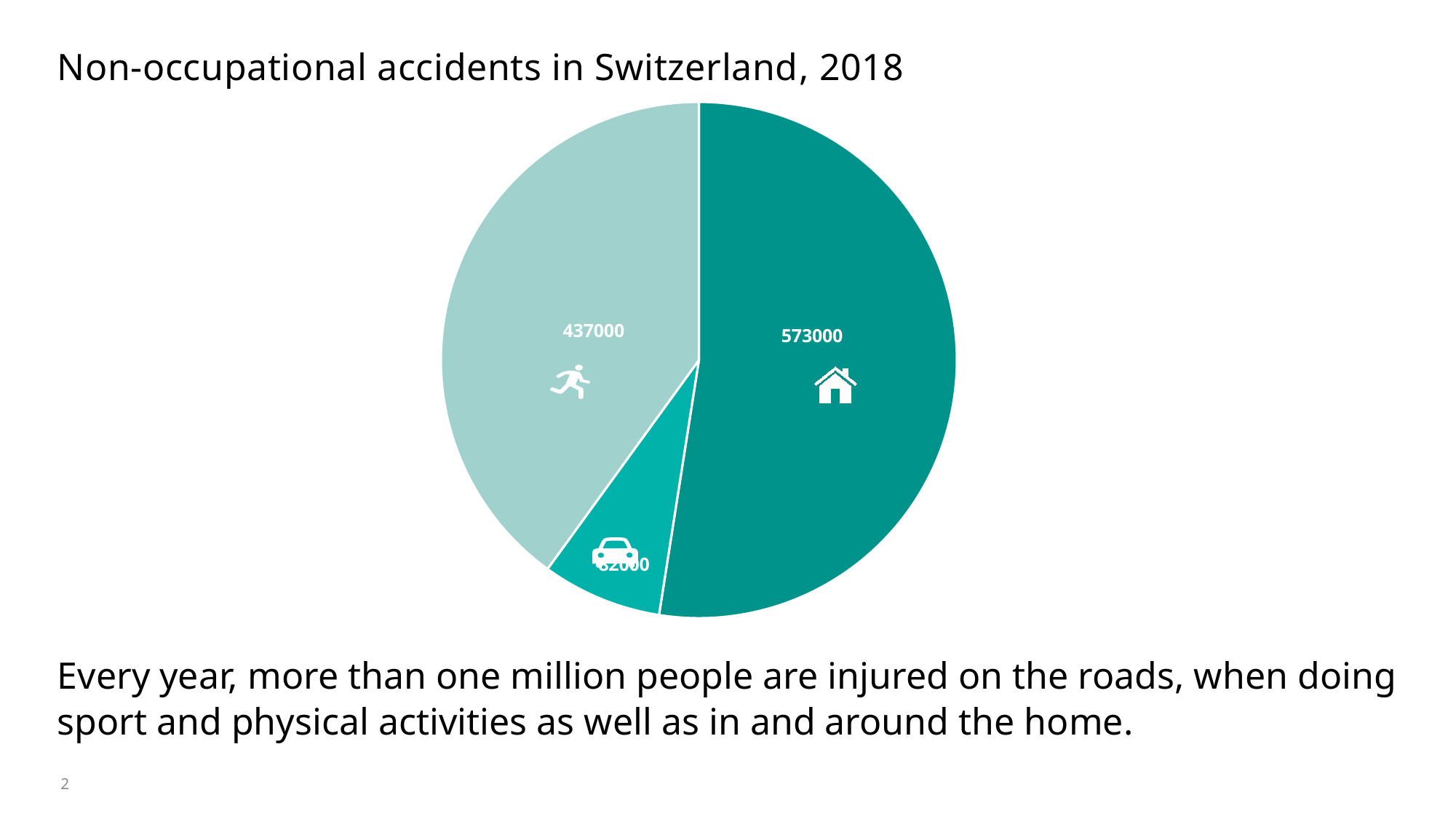
What value is shown on the slice with the house icon? 573000 How many slices does the pie chart have? 3 What value is shown on the slice with the running figure icon? 437000 What kind of chart is shown on the slide? Pie chart Which slice of the pie chart is the largest? The slice with the house icon (573000) What is the difference between the value of the house-icon slice and the running-figure slice? 136000 Which is larger: the slice with the house icon or the slice with the running figure icon? The slice with the house icon Which is larger: the slice with the car icon or the slice with the running figure icon? The slice with the running figure icon Which slice of the pie chart is the smallest? The slice with the car icon What is the title of the slide containing the pie chart? Non-occupational accidents in Switzerland, 2018 Which icon appears on the darkest-coloured slice of the pie chart? A house icon